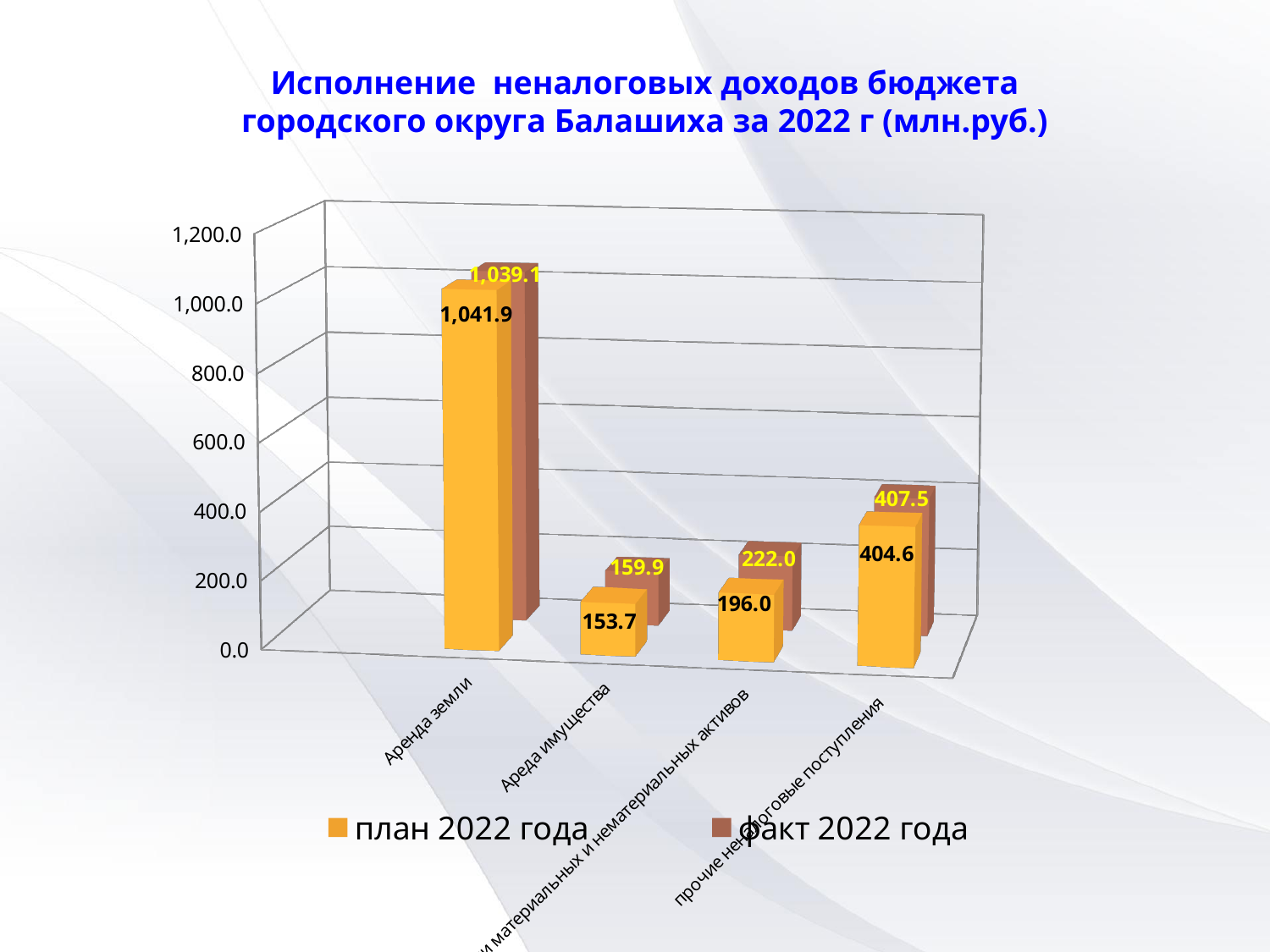
What kind of chart is shown on the slide? bar chart What is the факт 2022 года value for прочие неналоговые поступления? 407.5 What is the difference between the план 2022 года and факт 2022 года values for Аренда земли? 2.8 Which category has the lowest факт 2022 года value? Ареда имущества What is the план 2022 года value for Ареда имущества? 153.7 What is the план 2022 года value for Аренда земли? 1,041.9 What is the факт 2022 года value for Аренда земли? 1,039.1 What is the difference between the факт 2022 года and план 2022 года values for the category ending in 'материальных и нематериальных активов'? 26.0 How many categories are shown on the x axis? 4 Which category has the highest план 2022 года value? Аренда земли How many series does the legend list? 2 Which is larger for Ареда имущества: план 2022 года or факт 2022 года? факт 2022 года